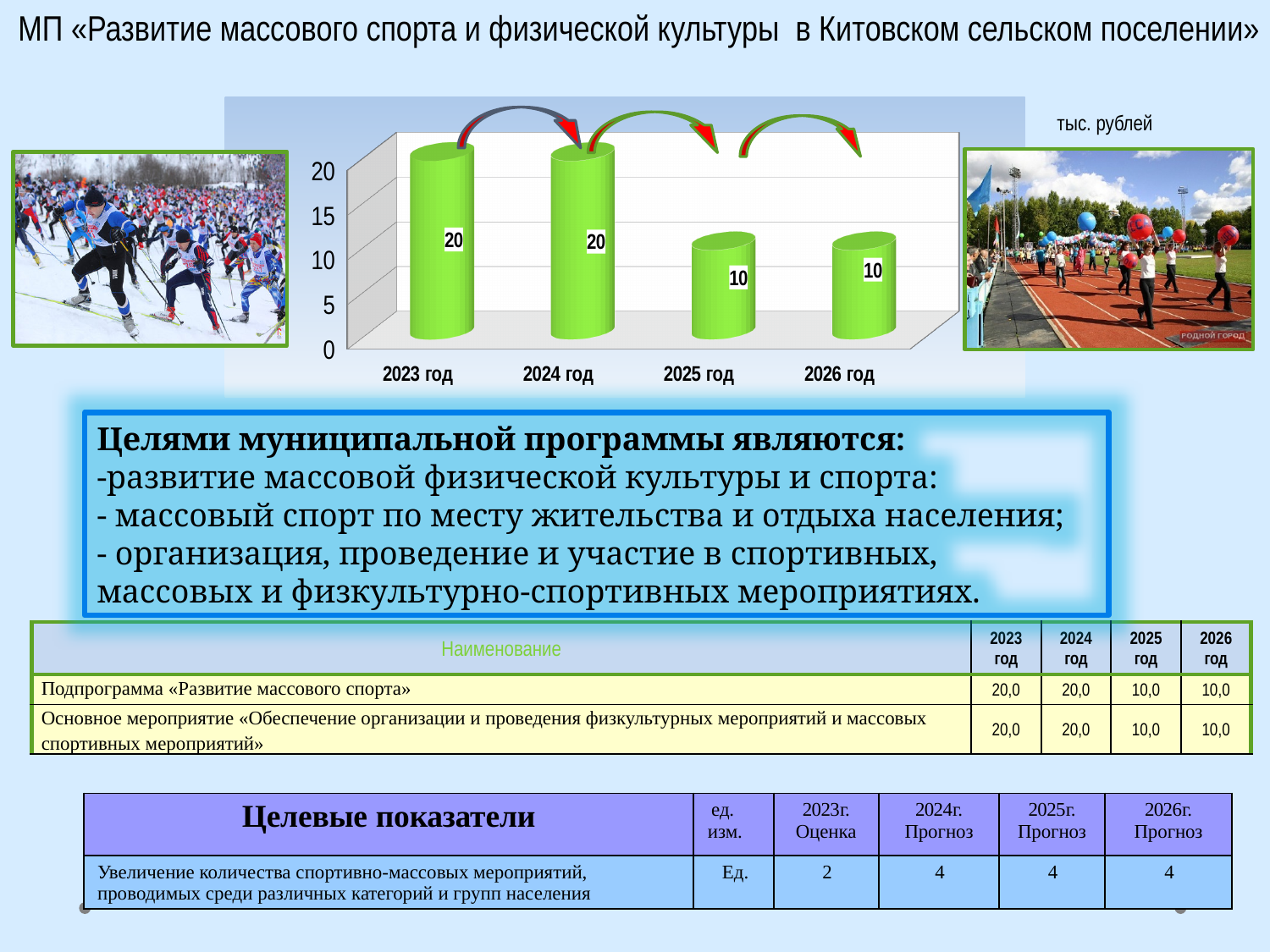
What is the value shown for 2023 год on the chart? 20 How many categories (years) are plotted on the chart? 4 Is the value for 2025 год greater or less than 15? less Which is larger, the value for 2023 год or the value for 2026 год? 2023 год What type of chart is shown on the slide? bar chart What unit of measurement is indicated next to the chart? тыс. рублей What is the difference between the values for 2024 год and 2025 год? 10 What colour are the bars on the chart? green What is the value shown for 2024 год on the chart? 20 Do the values on the chart rise or fall from 2023 год to 2026 год? fall What is the value shown for 2025 год on the chart? 10 What is the value shown for 2026 год on the chart? 10